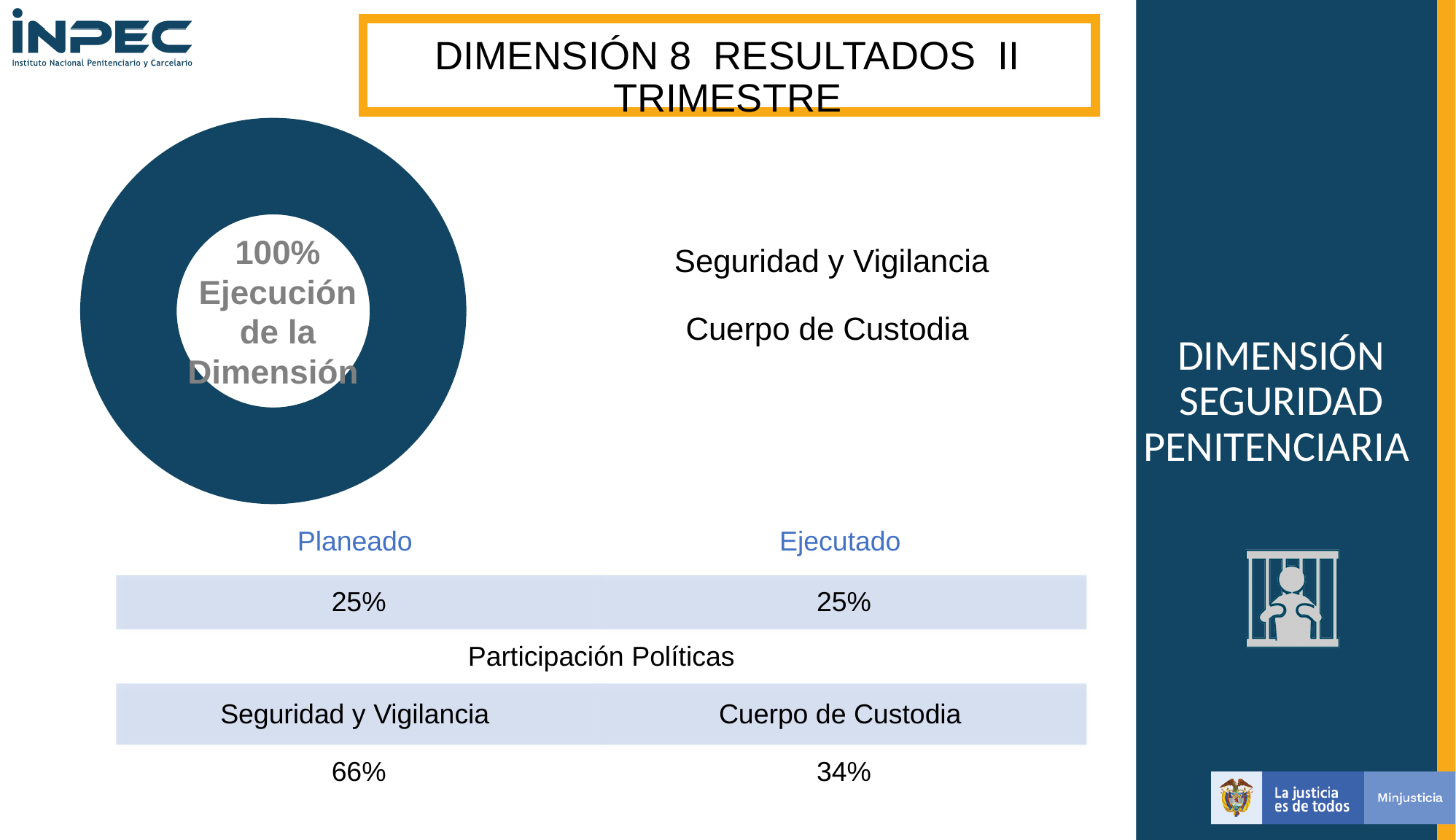
What share of the donut chart does the single slice occupy? 100% What colour is the ring of the donut chart? Dark blue Is the value shown in the donut chart greater or less than 50%? greater What percentage is printed in the centre of the donut chart? 100% What kind of chart is shown on the left of the slide? Donut chart What does the text in the centre of the donut chart say the 100% represents? Ejecución de la Dimensión How many slices does the donut chart contain? 1